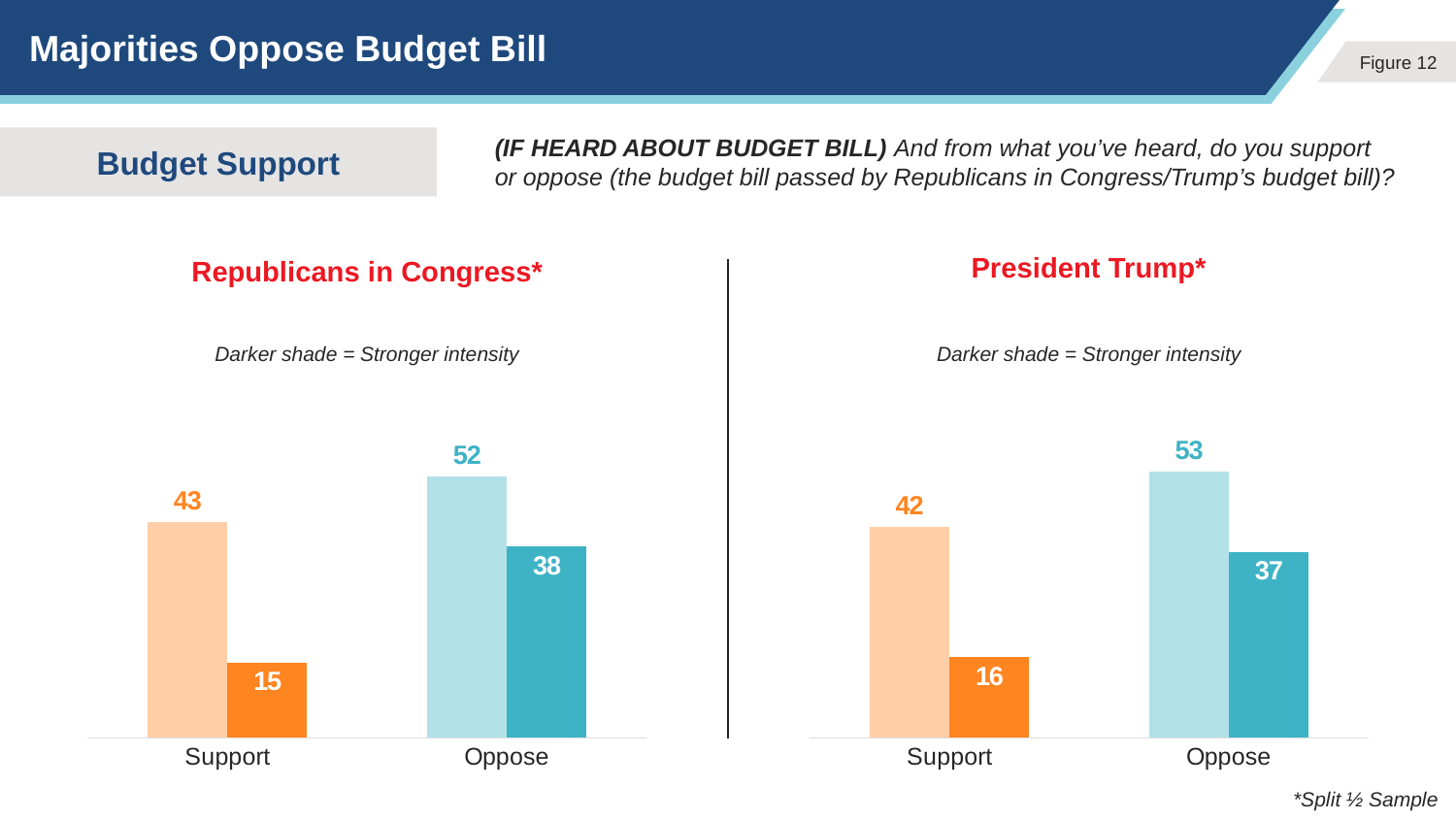
Which is larger: the lighter Oppose bar in the President Trump chart or the lighter Oppose bar in the Republicans in Congress chart? President Trump (53) In the Republicans in Congress chart, what is the difference between the lighter Oppose bar and the lighter Support bar? 9 In the President Trump chart, what is the value of the lighter Oppose bar? 53 In the President Trump chart, what is the difference between the darker Oppose bar and the darker Support bar? 21 In the Republicans in Congress chart, which bar has the highest value? Oppose (52) How many categories are shown on the x axis of the Republicans in Congress chart? 2 In the President Trump chart, what is the value of the darker (stronger intensity) Support bar? 16 What type of chart is used for the President Trump data? Bar chart In the President Trump chart, which bar has the lowest value? Support, darker shade (16) In the Republicans in Congress chart, what is the value of the lighter Support bar? 43 In the Republicans in Congress chart, what is the value of the darker (stronger intensity) Oppose bar? 38 According to the note on the charts, what does a darker shade indicate? Stronger intensity